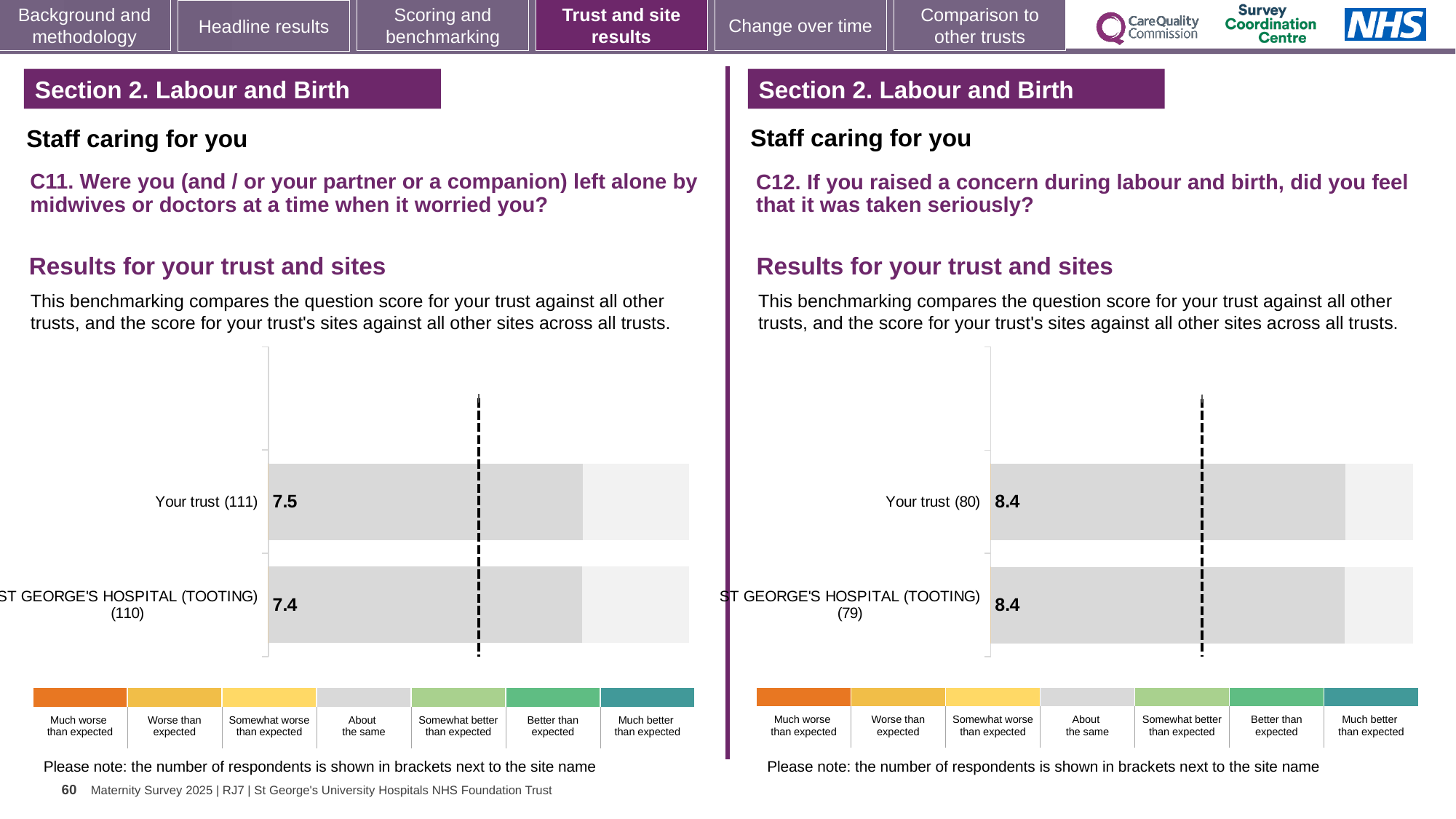
In the C11 chart on the left, what is the score for Your trust? 7.5 What type of chart is used in the C12 chart on the right? Bar chart In the C12 chart on the right, what is the score for Your trust? 8.4 In the C12 chart on the right, what is the score for St George's Hospital (Tooting)? 8.4 In the C12 chart on the right, what is the difference between the Your trust score and the St George's Hospital (Tooting) score? 0 In the C11 chart on the left, what is the score for St George's Hospital (Tooting)? 7.4 In the C11 chart on the left, which has the higher score, Your trust or St George's Hospital (Tooting)? Your trust In the C12 chart on the right, how many respondents are shown in brackets for St George's Hospital (Tooting)? 79 In the C12 chart on the right, is the score for Your trust higher than, lower than, or equal to the score for St George's Hospital (Tooting)? Equal In the C11 chart on the left, how many respondents are shown in brackets for Your trust? 111 In the C11 chart on the left, what is the difference between the Your trust score and the St George's Hospital (Tooting) score? 0.1 How many bars are plotted in the C11 chart on the left? 2